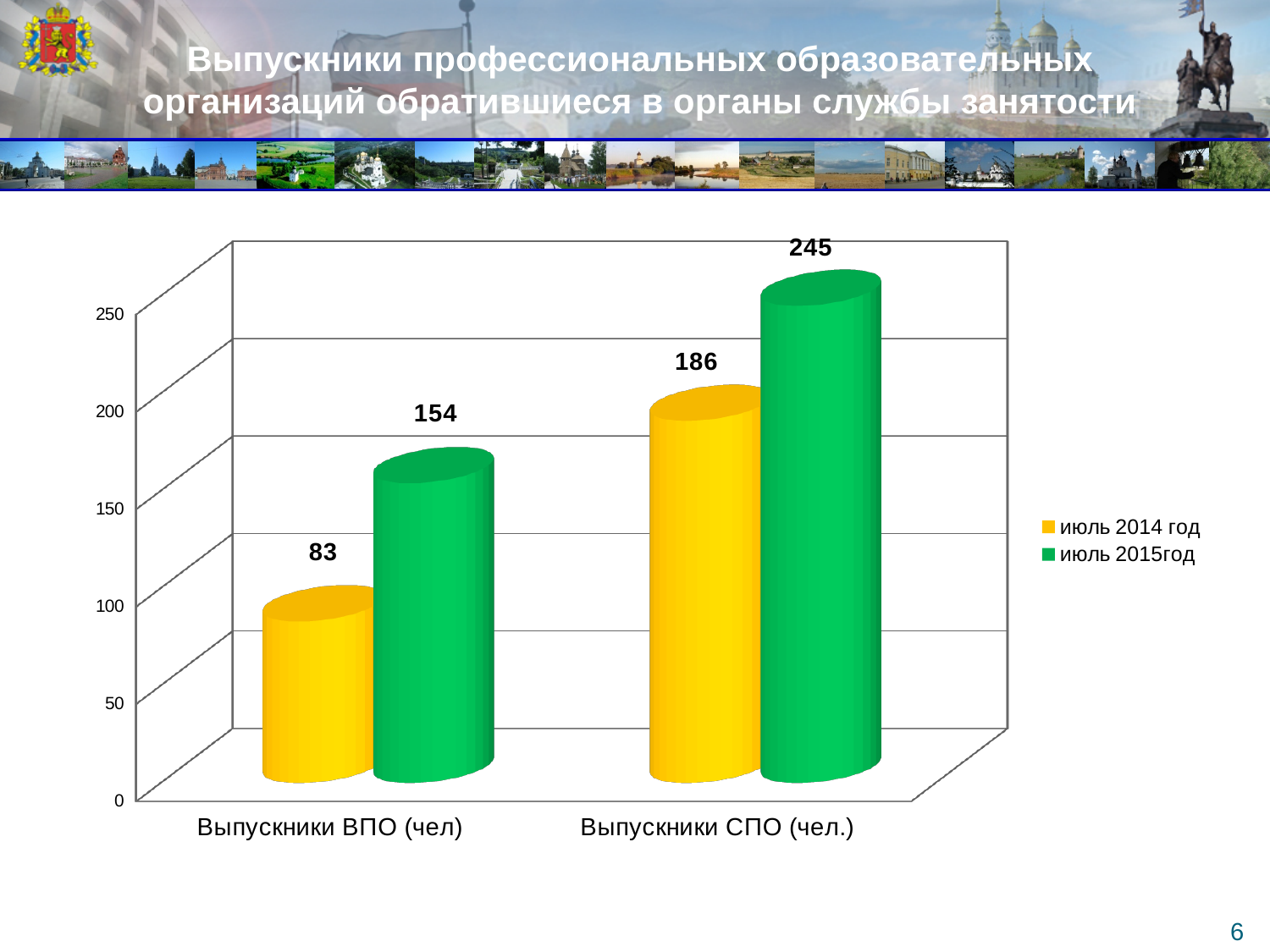
How many series does the legend list? 2 What is the value for Выпускники СПО (чел.) in июль 2014 год? 186 Which category has the lowest value in июль 2014 год? Выпускники ВПО (чел) What kind of chart is shown on the slide? Bar chart What is the value for Выпускники СПО (чел.) in июль 2015год? 245 What is the value for Выпускники ВПО (чел) in июль 2015год? 154 What is the difference between the июль 2015год and июль 2014 год values for Выпускники ВПО (чел)? 71 Which category has the highest value in июль 2015год? Выпускники СПО (чел.) What is the difference between the июль 2015год and июль 2014 год values for Выпускники СПО (чел.)? 59 Which is larger: Выпускники СПО (чел.) in июль 2014 год or Выпускники ВПО (чел) in июль 2015год? Выпускники СПО (чел.) in июль 2014 год What is the value for Выпускники ВПО (чел) in июль 2014 год? 83 How many categories are shown on the x axis? 2